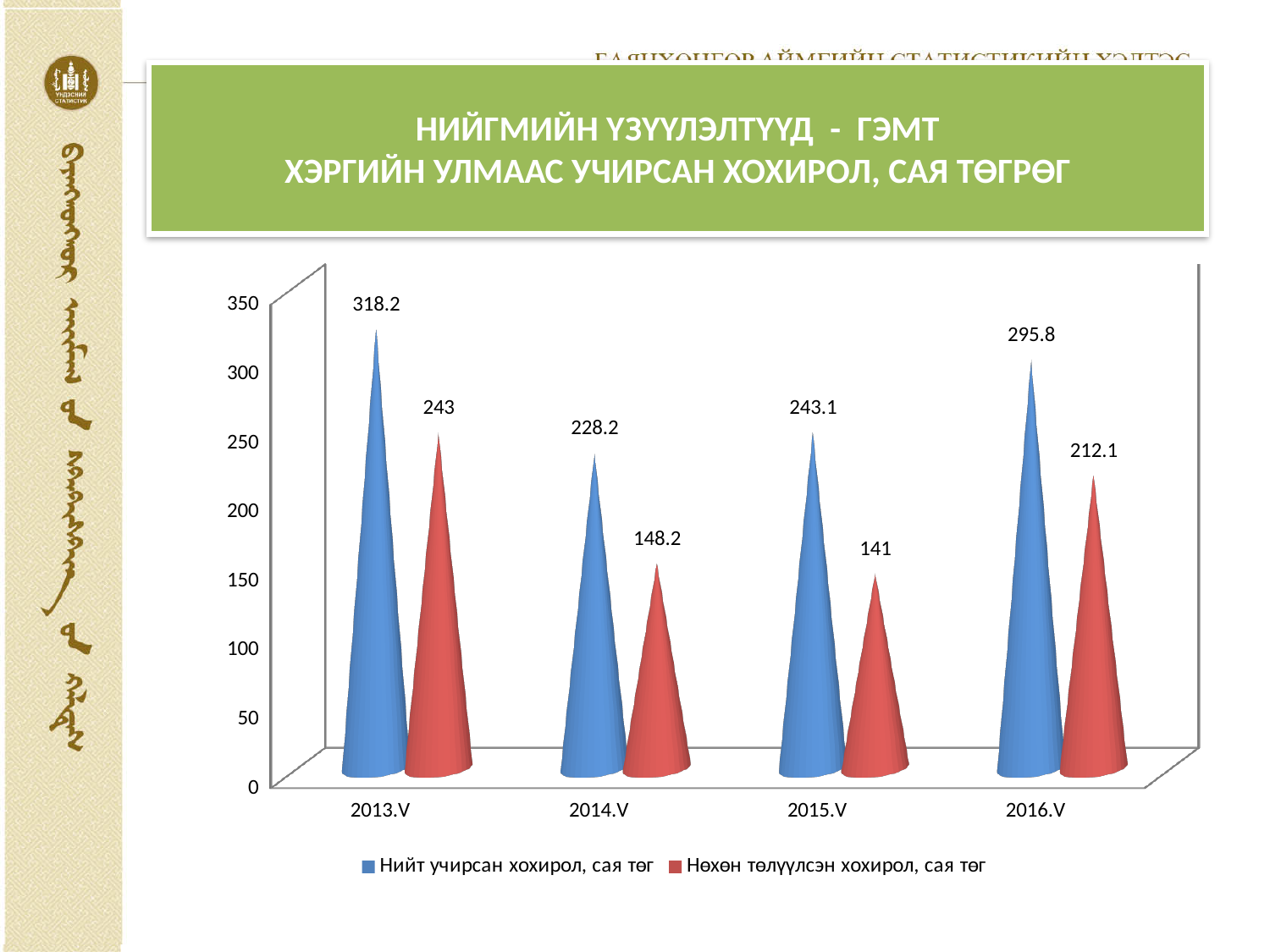
Which colour represents 'Нөхөн төлүүлсэн хохирол, сая төг' in the chart? red What is the difference between 'Нийт учирсан хохирол, сая төг' and 'Нөхөн төлүүлсэн хохирол, сая төг' in 2014.V? 80 What is the value of 'Нөхөн төлүүлсэн хохирол, сая төг' for 2015.V? 141 In which period is 'Нийт учирсан хохирол, сая төг' the highest? 2013.V What is the value of 'Нийт учирсан хохирол, сая төг' for 2013.V? 318.2 What is the value of 'Нөхөн төлүүлсэн хохирол, сая төг' for 2016.V? 212.1 Which is larger: 'Нийт учирсан хохирол, сая төг' in 2015.V or in 2016.V? 2016.V How many periods are shown on the x axis? 4 How many series does the legend list? 2 Is the value of 'Нөхөн төлүүлсэн хохирол, сая төг' for 2013.V greater or less than 200? greater What kind of chart is shown on the slide? bar chart In which period is 'Нөхөн төлүүлсэн хохирол, сая төг' the lowest? 2015.V